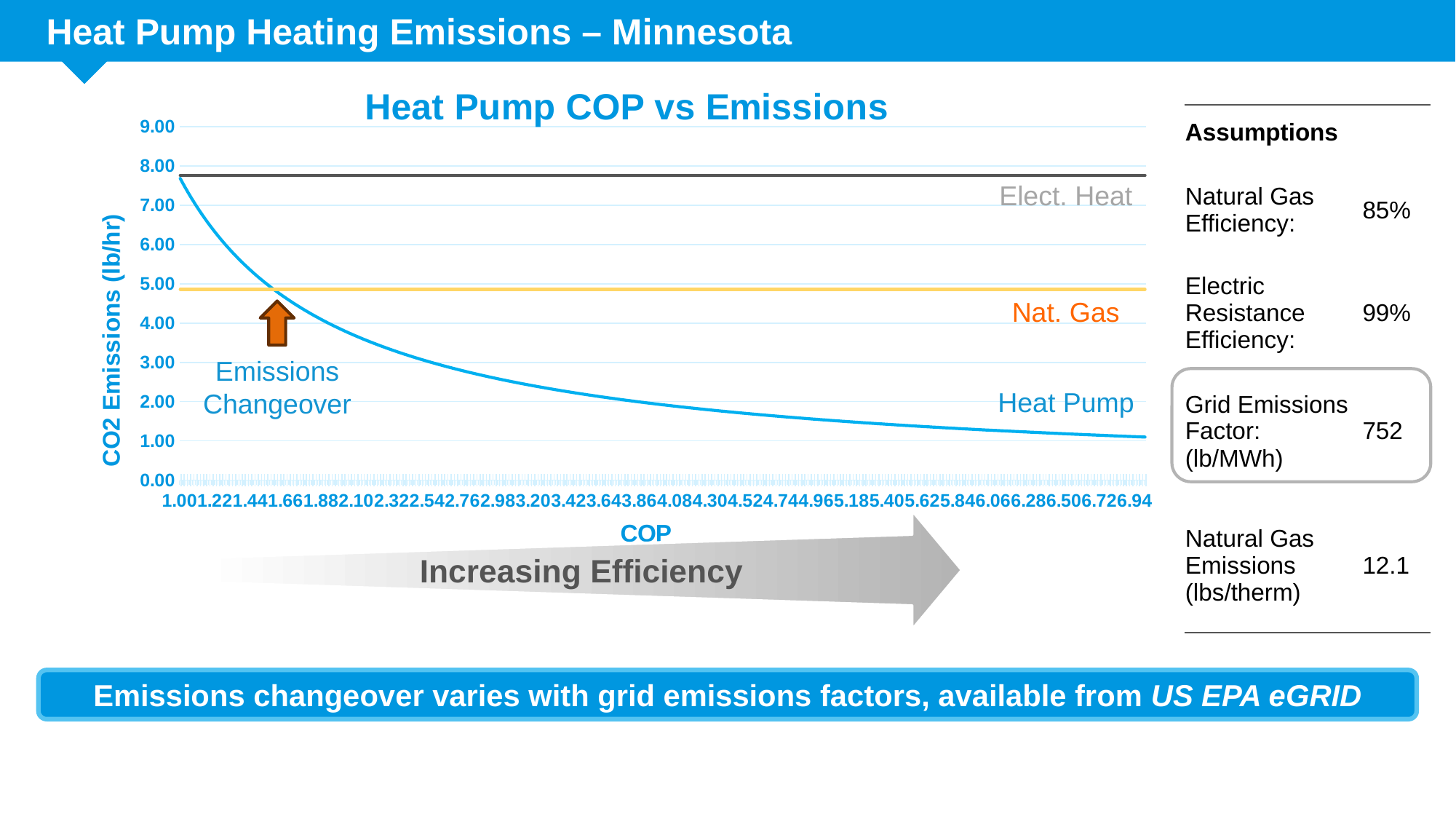
Which series has the highest CO2 emissions on the chart? Elect. Heat Is the value for Heat Pump at a COP of 6.94 greater or less than 2.00? less What is the label of the vertical axis of the chart? CO2 Emissions (lb/hr) Which is larger, the emissions for Elect. Heat or for Nat. Gas? Elect. Heat What kind of chart is shown on the slide? line chart At a COP of 6.94, which is larger, the emissions for Heat Pump or for Nat. Gas? Nat. Gas How many series are plotted on the chart? 3 Is the value for Elect. Heat greater or less than 7.00? greater Does the Heat Pump line rise or fall as COP increases? fall What is the title of the chart? Heat Pump COP vs Emissions Which series has the lowest CO2 emissions at the highest COP shown (6.94)? Heat Pump Is the value for Nat. Gas greater or less than 4.00? greater